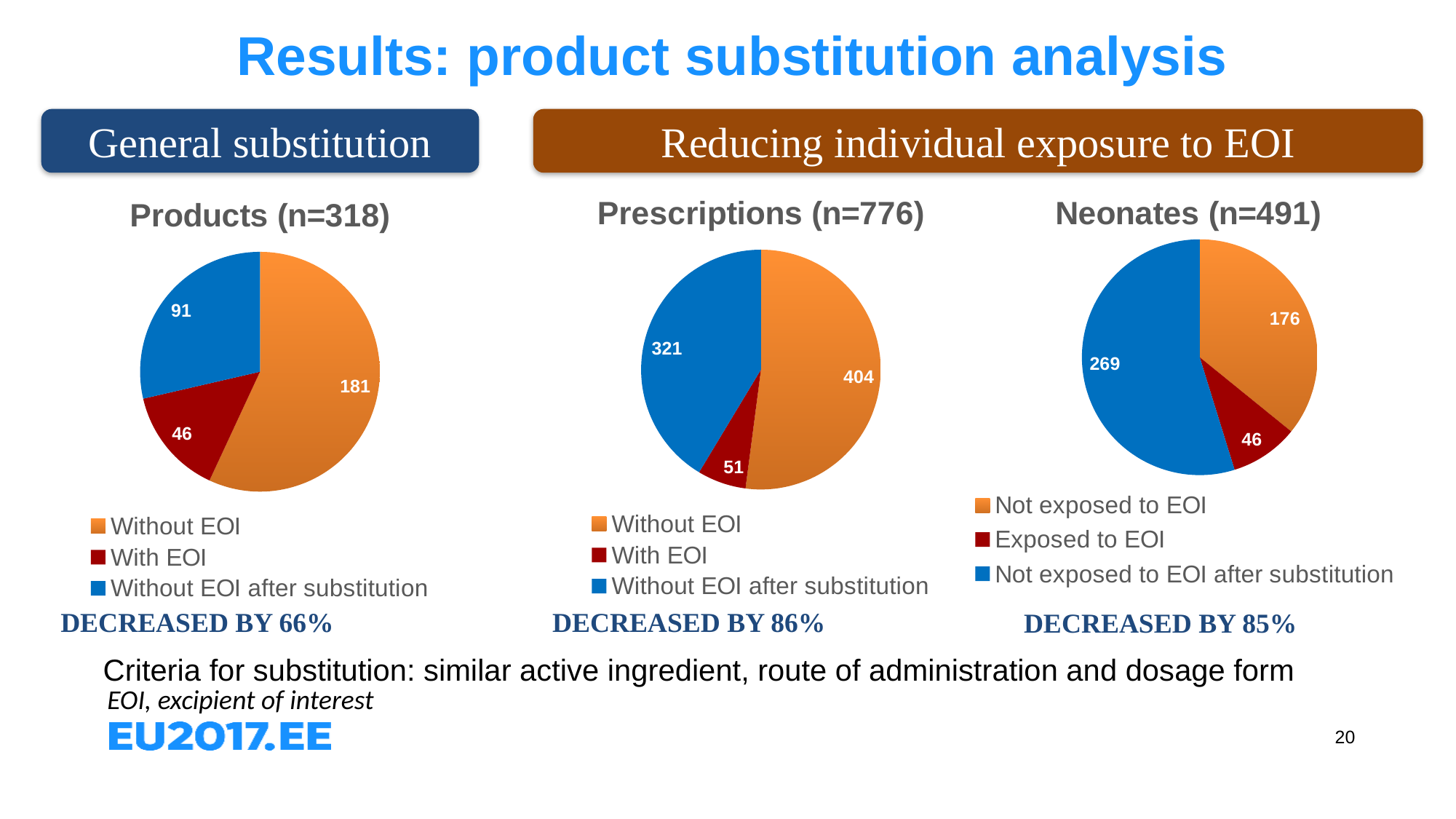
How many slices does the Products (n=318) chart have? 3 In the Prescriptions (n=776) chart, what colour is the With EOI slice? Dark red In the Products (n=318) chart, what share of the total does the With EOI slice represent, to the nearest whole percent? 14% In the Products (n=318) chart, what is the value for With EOI? 46 In the Neonates (n=491) chart, what is the value for Not exposed to EOI? 176 What type of chart is used for Neonates (n=491)? Pie chart In the Products (n=318) chart, what is the value for Without EOI? 181 In the Prescriptions (n=776) chart, which category has the largest slice? Without EOI In the Neonates (n=491) chart, which category has the smallest slice? Exposed to EOI In the Prescriptions (n=776) chart, what is the difference between Without EOI and Without EOI after substitution? 83 In the Prescriptions (n=776) chart, what is the value for Without EOI after substitution? 321 In the Neonates (n=491) chart, which is larger: Not exposed to EOI or Not exposed to EOI after substitution? Not exposed to EOI after substitution